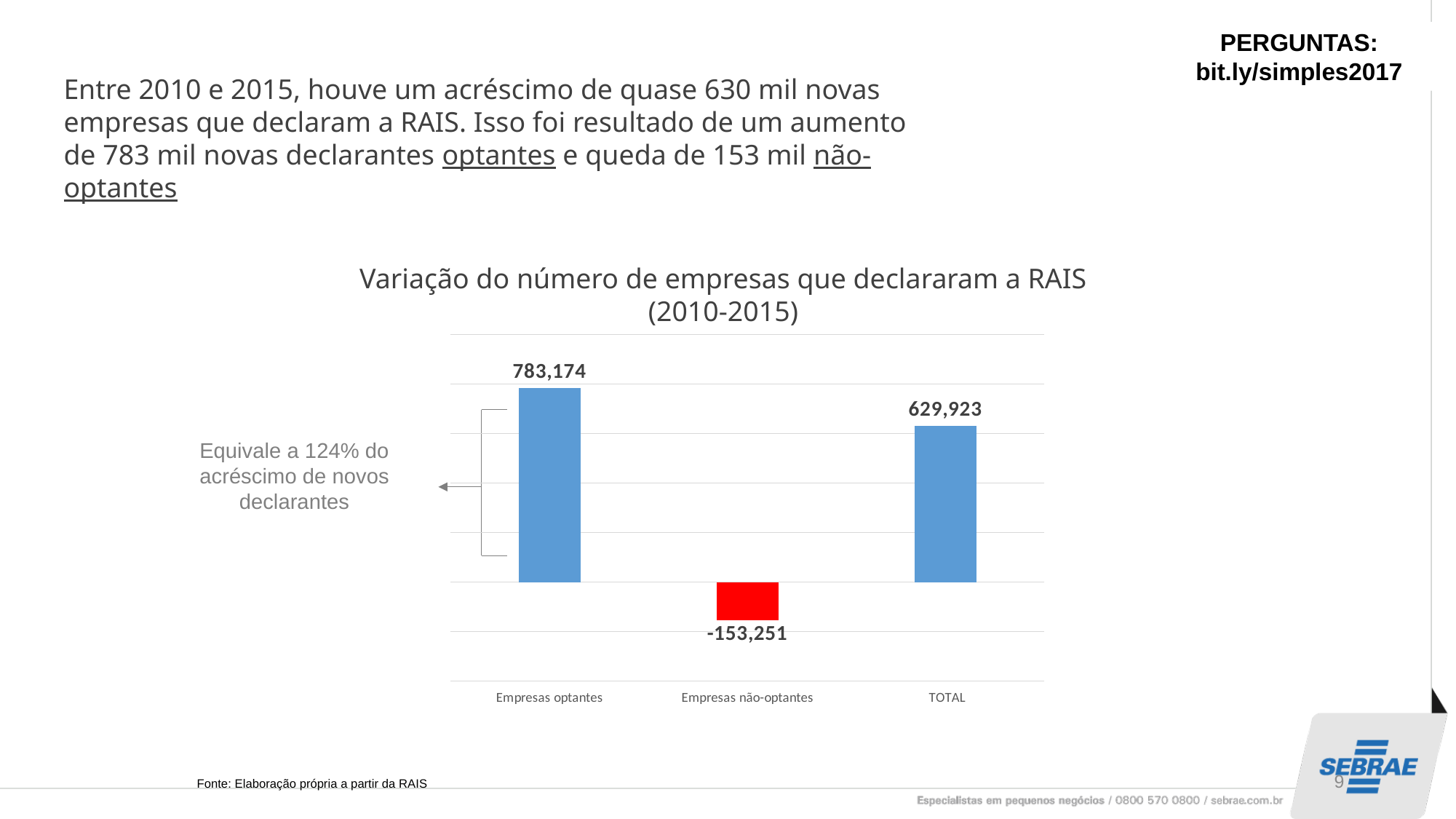
Which category has the highest value? Empresas optantes Which is larger, the value for TOTAL or the value for Empresas não-optantes? TOTAL What is the difference between the values for Empresas optantes and Empresas não-optantes? 936,425 What is the value for Empresas não-optantes? -153,251 What is the value for TOTAL? 629,923 What is the value for Empresas optantes? 783,174 How many categories are shown in the chart? 3 What is the difference between the values for Empresas optantes and TOTAL? 153,251 Which category has the lowest value? Empresas não-optantes What kind of chart is shown on the slide? Bar chart What is the title of the chart? Variação do número de empresas que declararam a RAIS (2010-2015) Which category's bar is coloured red? Empresas não-optantes